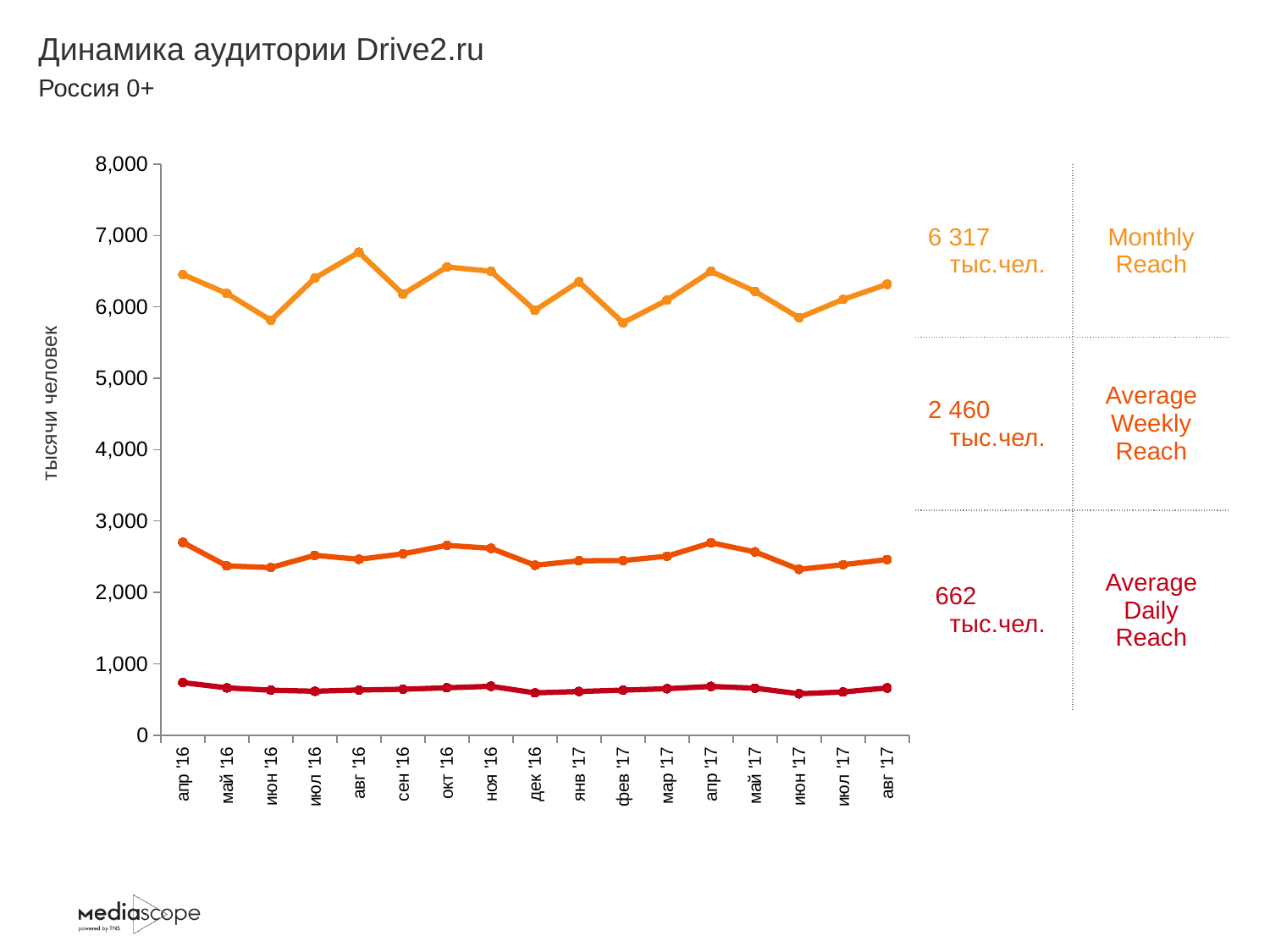
What kind of chart is shown on the slide? line chart Is the Average Daily Reach value for ноя '16 greater or less than 1,000? less Is the Monthly Reach value for июн '16 greater or less than 6,000? less How many months are shown along the x axis of the chart? 17 Does the Monthly Reach line rise or fall from июн '16 to авг '16? rise Which is larger, the Monthly Reach for авг '16 or for июн '16? авг '16 Is the Monthly Reach value for авг '16 greater or less than 6,000? greater Which month has the highest Monthly Reach value? авг '16 What is the label on the vertical axis of the chart? тысячи человек Which month has the highest Average Daily Reach value? апр '16 How many series are plotted on the chart? 3